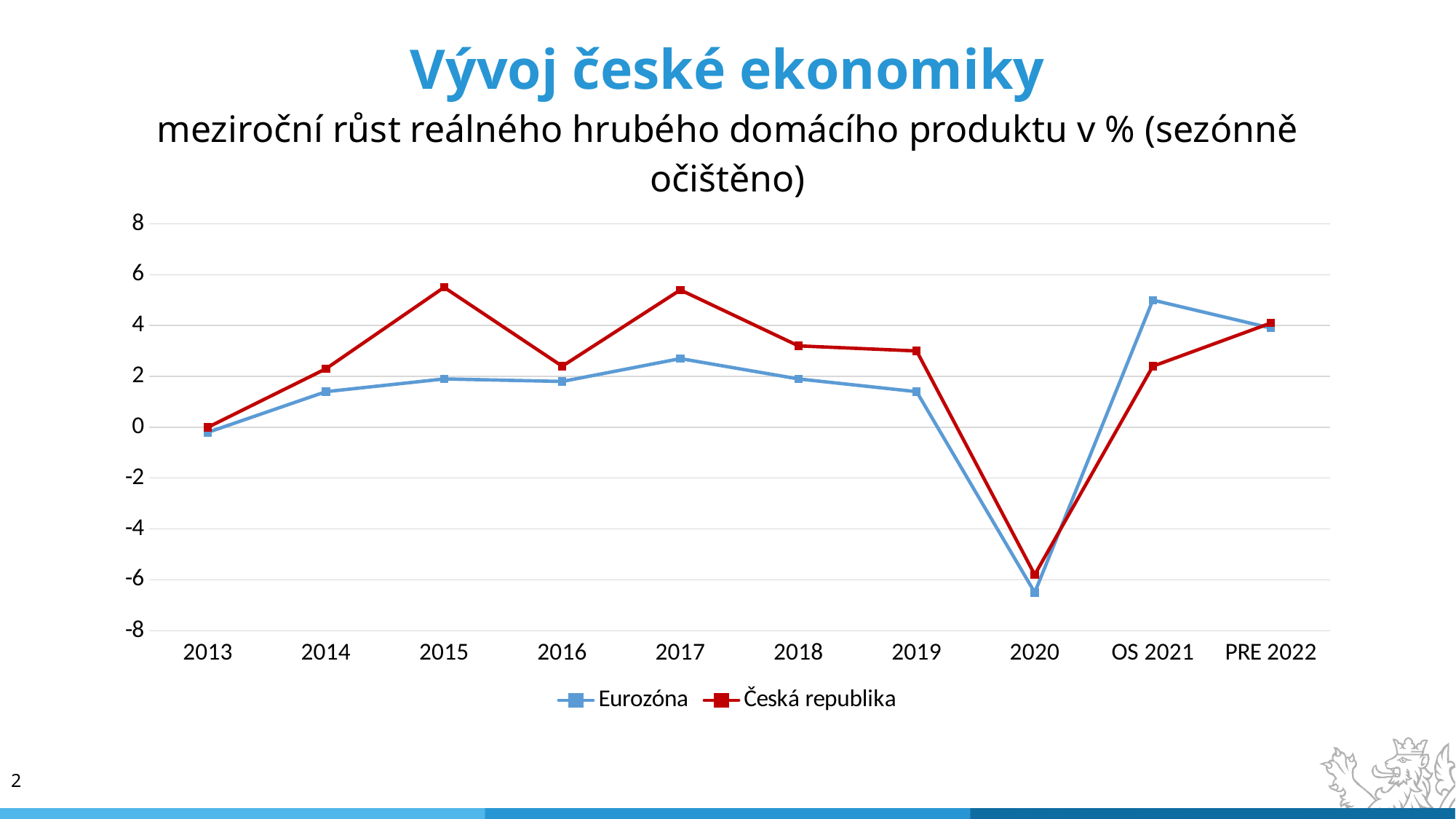
In which category does the Eurozóna series reach its highest value? OS 2021 How many series does the legend list? 2 Is the value for Eurozóna in 2020 greater or less than -4? less Is the value for Eurozóna in OS 2021 greater or less than 4? greater Which series is drawn in red? Česká republika Does the Eurozóna series rise or fall from 2017 to 2020? fall Which series has the higher value in OS 2021, Eurozóna or Česká republika? Eurozóna How many categories are shown on the x axis? 10 Is the value for Česká republika in 2015 greater or less than 4? greater What kind of chart is shown on the slide? line chart Which series has the higher value in 2015, Eurozóna or Česká republika? Česká republika In which category does the Česká republika series reach its lowest value? 2020